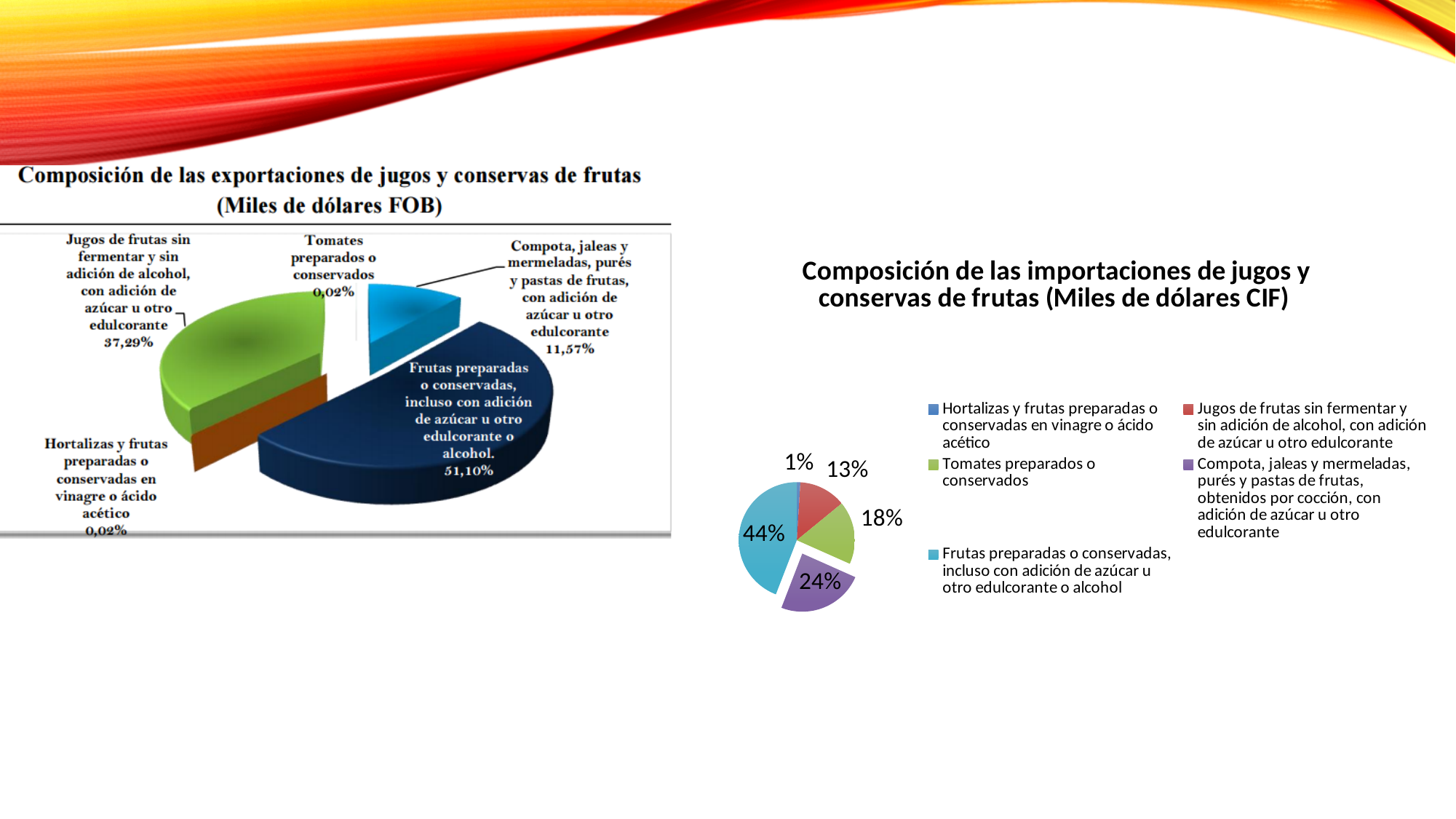
In the right chart (Composición de las importaciones), what share do Frutas preparadas o conservadas, incluso con adición de azúcar u otro edulcorante o alcohol have? 44% In the left chart (Composición de las exportaciones), what is the difference between the shares of Frutas preparadas o conservadas and Jugos de frutas sin fermentar? 13,81% In the left chart (Composición de las exportaciones), what share do Frutas preparadas o conservadas, incluso con adición de azúcar u otro edulcorante o alcohol have? 51,10% In the right chart (Composición de las importaciones), which is larger: the share of Compota, jaleas y mermeladas or the share of Jugos de frutas sin fermentar? Compota, jaleas y mermeladas In the left chart (Composición de las exportaciones), what share do Jugos de frutas sin fermentar y sin adición de alcohol have? 37,29% In the left chart (Composición de las exportaciones), what share do Compota, jaleas y mermeladas, purés y pastas de frutas have? 11,57% In the left chart (Composición de las exportaciones), which category has the largest share? Frutas preparadas o conservadas, incluso con adición de azúcar u otro edulcorante o alcohol In the right chart (Composición de las importaciones), how many entries does the legend list? 5 In the right chart (Composición de las importaciones), which category has the smallest share? Hortalizas y frutas preparadas o conservadas en vinagre o ácido acético What type of chart is used on the right side of the slide (Composición de las importaciones)? Pie chart In the right chart (Composición de las importaciones), what share do Tomates preparados o conservados have? 18% In the left chart (Composición de las exportaciones), how many categories are shown? 5